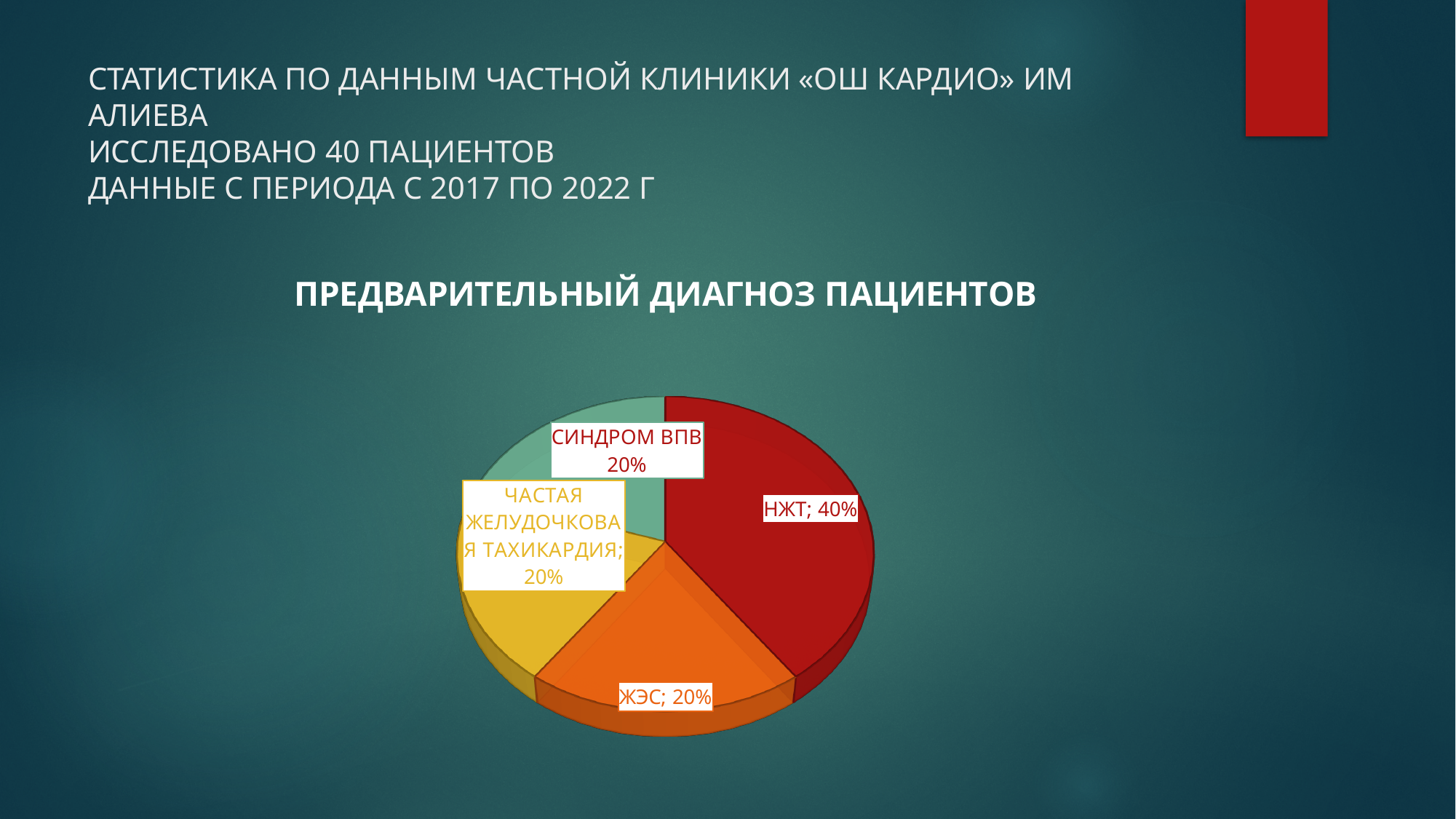
What share of the pie does ЧАСТАЯ ЖЕЛУДОЧКОВАЯ ТАХИКАРДИЯ represent? 20% What share of the pie does СИНДРОМ ВПВ represent? 20% What share of the pie does ЖЭС represent? 20% What is the combined share of ЖЭС and СИНДРОМ ВПВ? 40% Which is larger, the share for НЖТ or the share for СИНДРОМ ВПВ? НЖТ How many slices does the pie chart have? 4 Which diagnosis has the largest share of the pie? НЖТ What is the difference between the share for НЖТ and the share for ЖЭС? 20% What share of the pie does НЖТ represent? 40% What is the title of the chart? ПРЕДВАРИТЕЛЬНЫЙ ДИАГНОЗ ПАЦИЕНТОВ What colour is the НЖТ slice? Red What type of chart is shown on the slide? Pie chart